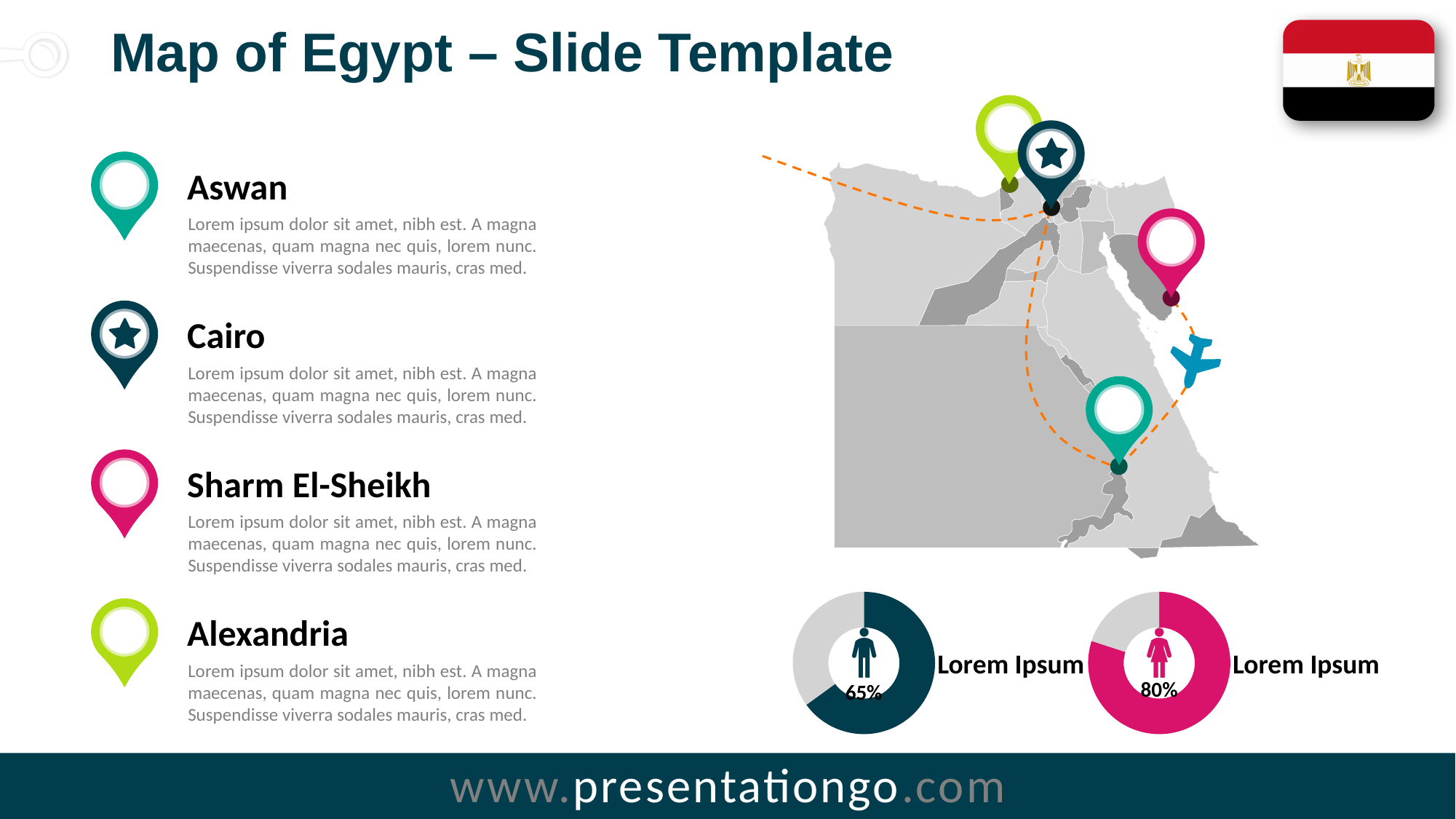
What label text appears next to each donut chart? Lorem Ipsum What percentage is shown in the centre of the left donut chart (with the male figure icon)? 65% What kind of charts are shown at the bottom right of the slide? Donut (pie) charts Is the value shown in the left donut chart greater or less than 50%? greater Which donut chart shows the larger percentage, the left one with the male icon or the right one with the female icon? The right one (female icon), 80% What colour is the filled segment of the left donut chart? Dark teal How many donut charts are on the slide? 2 What is the difference between the percentage in the right donut chart and the percentage in the left donut chart? 15 percentage points What share of the right donut chart is filled with the coloured segment? 80% What percentage is shown in the centre of the right donut chart (with the female figure icon)? 80%